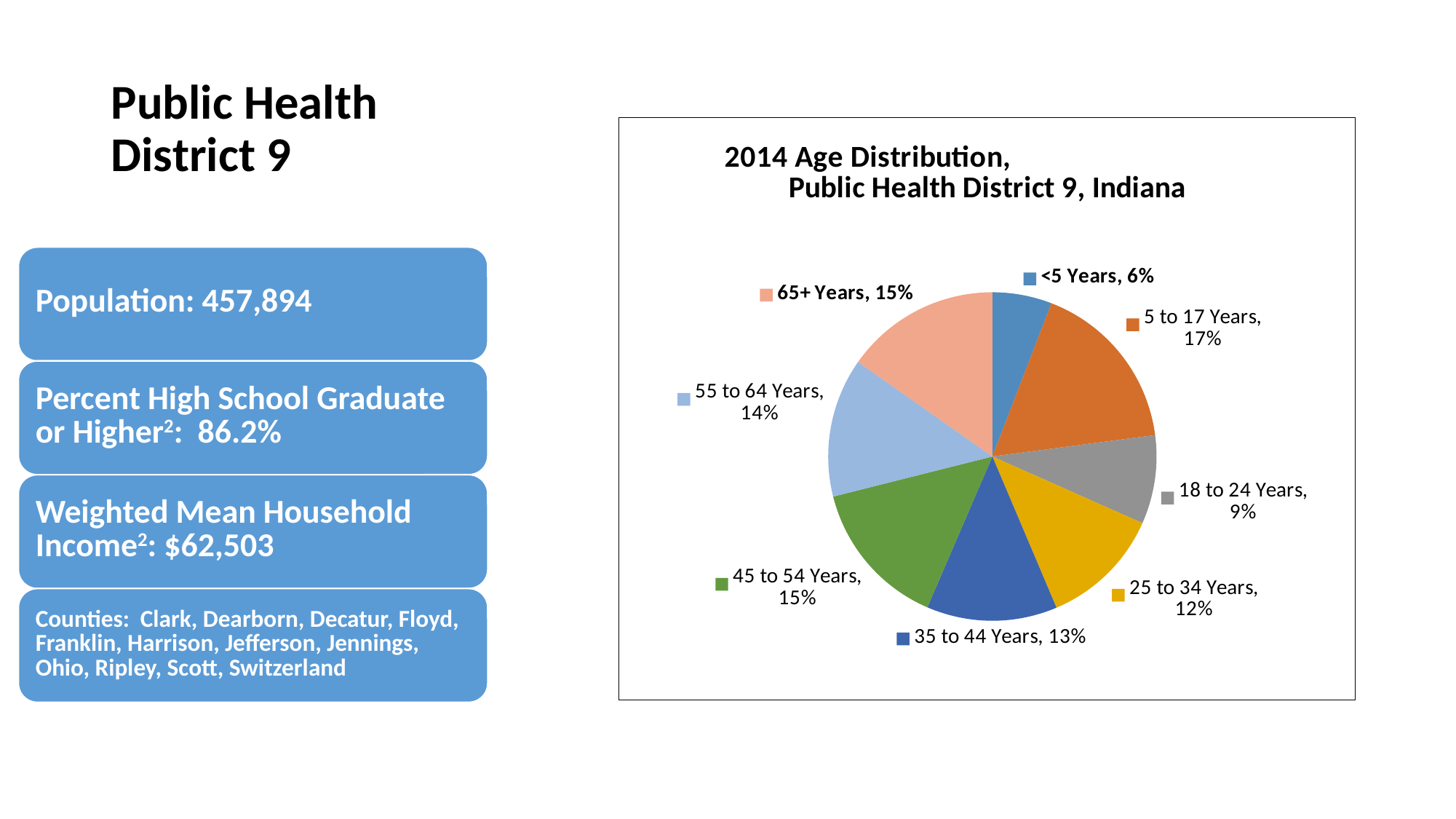
What is the title of the chart? 2014 Age Distribution, Public Health District 9, Indiana What is the difference in percentage points between the 5 to 17 Years slice and the 25 to 34 Years slice? 5 What percentage is shown for the <5 Years category? 6% Which age group has the largest share of the pie? 5 to 17 Years How many age categories are shown in the pie chart? 8 What percentage is shown for the 35 to 44 Years category? 13% Which is larger, the share for 55 to 64 Years or the share for 18 to 24 Years? 55 to 64 Years What type of chart is shown on the slide? Pie chart What percentage is shown for the 18 to 24 Years category? 9% What colour is the 45 to 54 Years slice? Green Which age group has the smallest share of the pie? <5 Years What share of the pie is the 5 to 17 Years slice? 17%